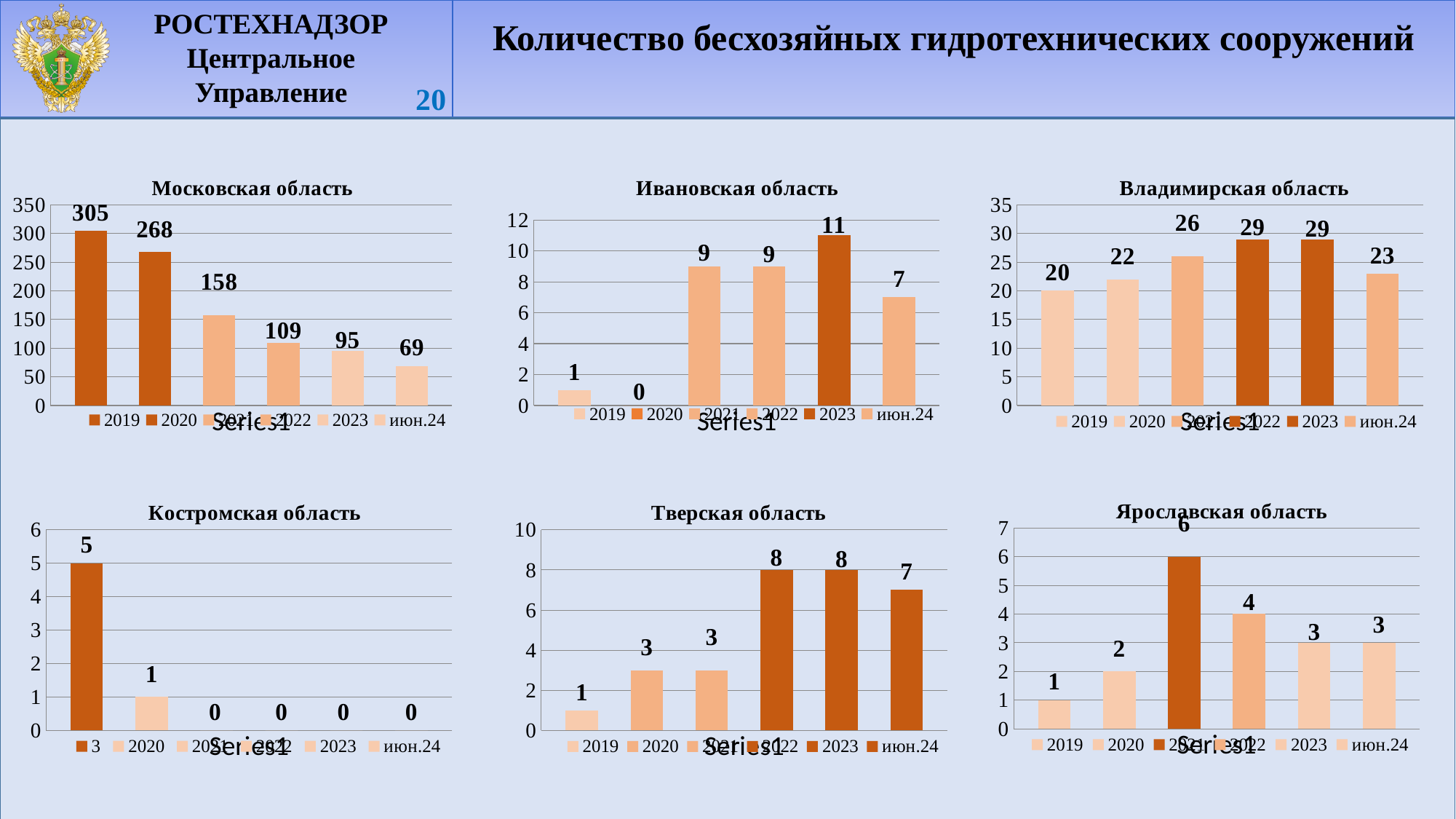
What type of chart is the Ярославская область chart? bar chart In the Владимирская область chart, what is the value for 2019? 20 In the Московская область chart, what is the value for июн.24? 69 In the Ярославская область chart, what is the highest value shown? 6 In the Ивановская область chart, which bar has the highest value? 2023 In the Московская область chart, what is the difference between the 2019 and 2020 values? 37 In the Московская область chart, what is the value for 2019? 305 In the Московская область chart, do the values rise or fall from left to right? fall In the Тверская область chart, which is larger, the value for 2020 or the value for июн.24? июн.24 In the Владимирская область chart, is the value for 2023 greater or less than 25? greater In the Ивановская область chart, what is the value for 2020? 0 In the Костромская область chart, how many bars are plotted? 6